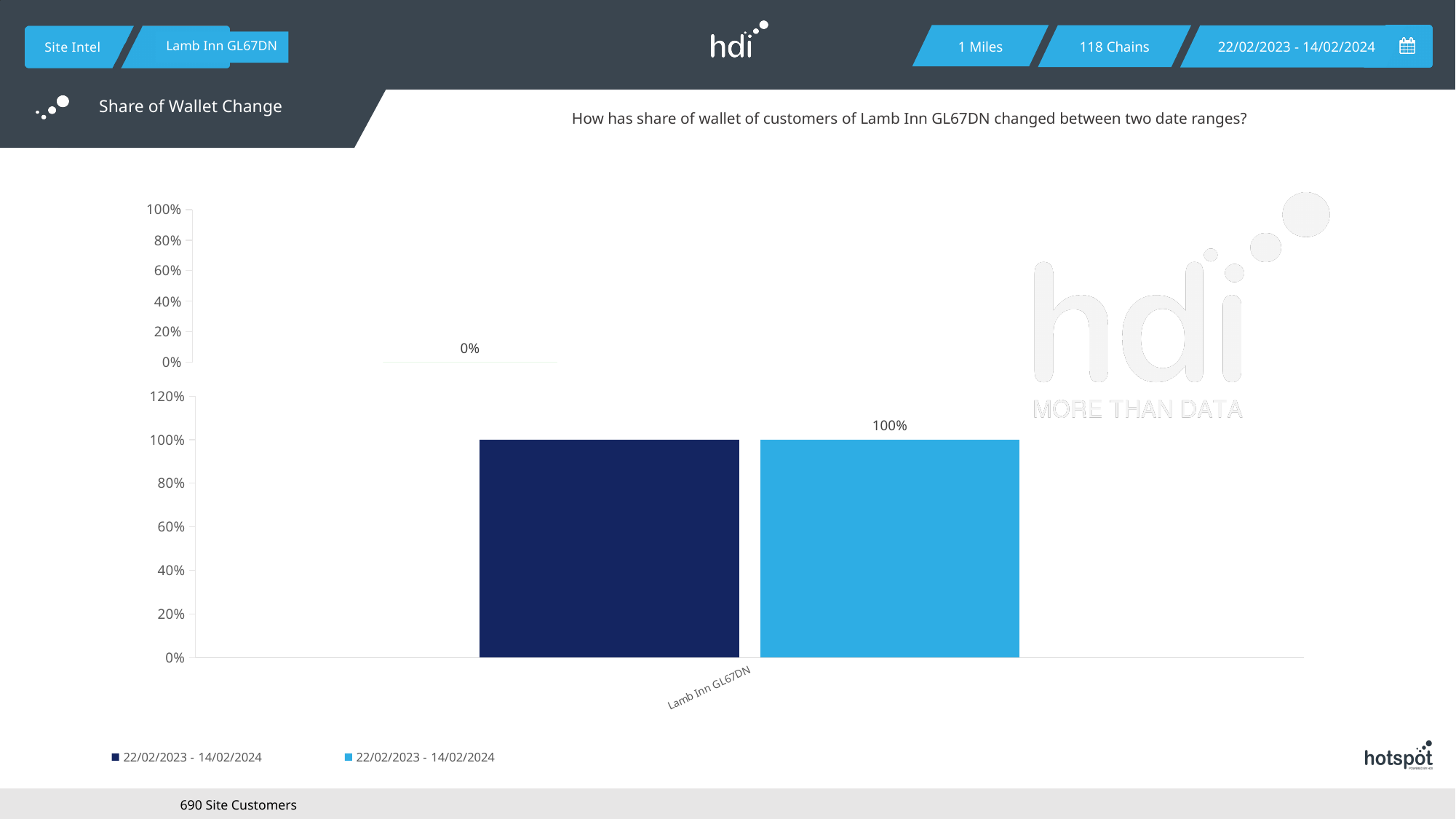
What date range do the legend entries show? 22/02/2023 - 14/02/2024 How many series does the legend list? 2 What value is printed above the light blue bar for Lamb Inn GL67DN in the lower chart? 100% Is the value of the dark blue bar for Lamb Inn GL67DN in the lower chart greater or less than 80%? greater What is the title of the chart on the slide? Share of Wallet Change What kind of chart is shown on the slide? bar chart What is the category label on the x axis of the lower bar chart? Lamb Inn GL67DN What value is printed as the data label in the upper panel of the chart? 0% How many categories are shown on the x axis of the lower bar chart? 1 What is the highest tick value shown on the y axis of the lower bar chart? 120% Is the value of the light blue bar for Lamb Inn GL67DN in the lower chart greater or less than 120%? less